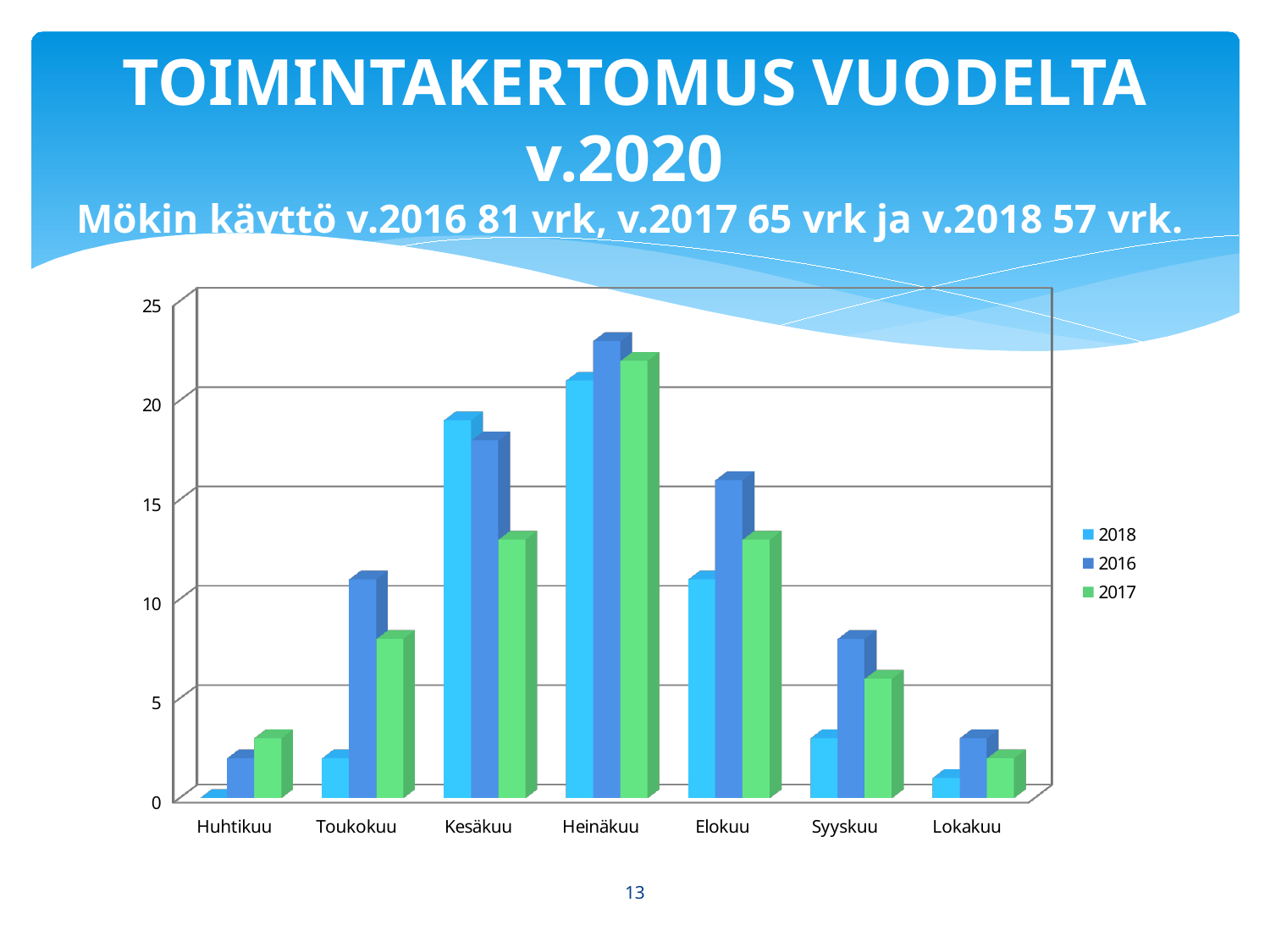
How many months (categories) are shown on the x axis of the chart? 7 What kind of chart is shown on the slide? bar chart How many series does the chart legend list? 3 Which series are listed in the chart legend? 2018, 2016, 2017 For Syyskuu, which is larger: the 2016 value or the 2018 value? 2016 In which month is the 2017 value highest? Heinäkuu For Elokuu, which is larger: the 2016 value or the 2018 value? 2016 In which month is the 2018 value lowest? Huhtikuu In which month is the 2016 value highest? Heinäkuu Is the 2017 value for Kesäkuu greater or less than 10? greater Is the 2017 value for Heinäkuu greater or less than 20? greater Is the 2016 value for Toukokuu greater or less than 10? greater